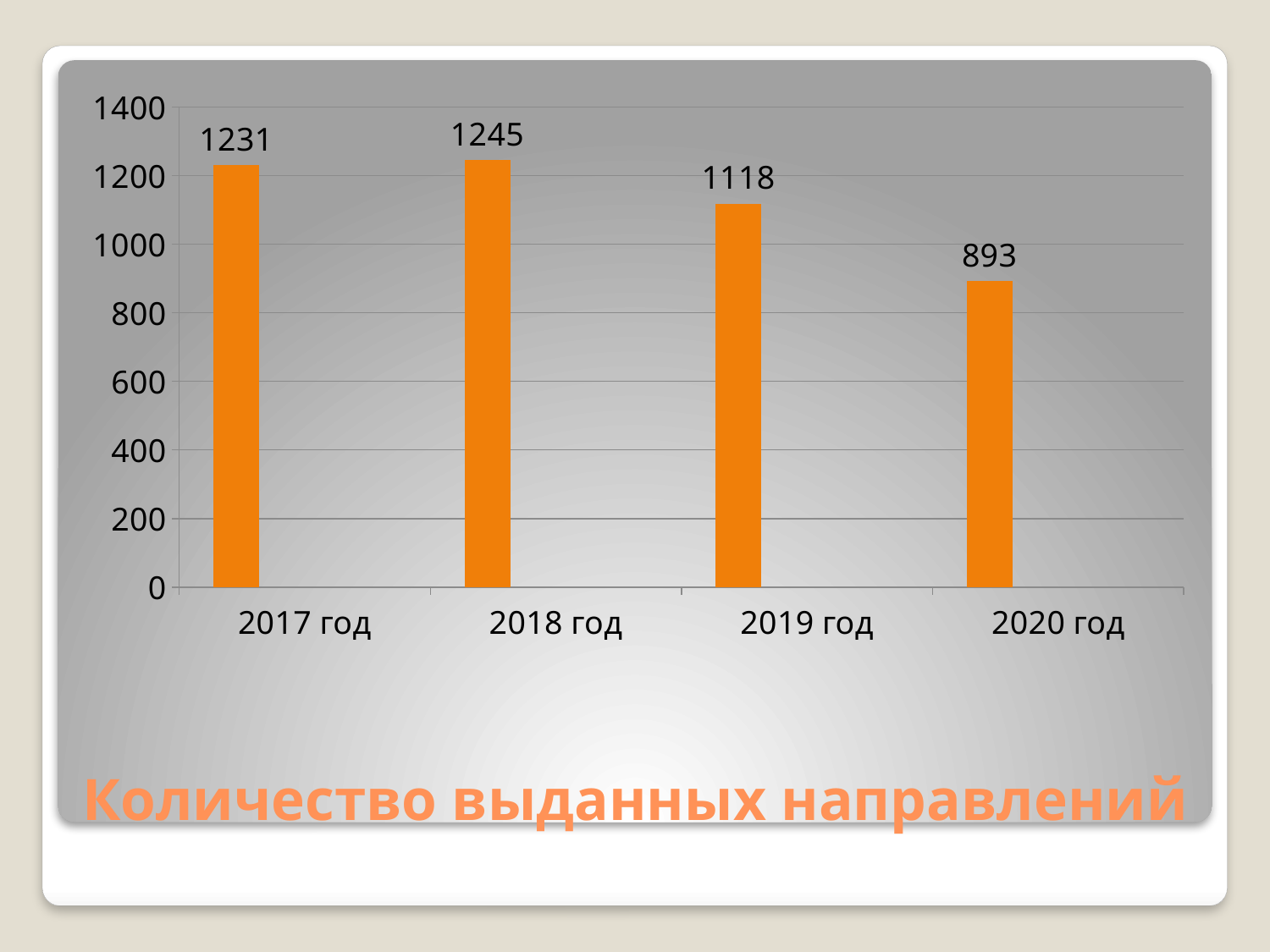
How many years are shown on the chart? 4 What is the value for 2020 год? 893 Which is larger, the value for 2017 год or the value for 2019 год? 2017 год What is the title of the chart? Количество выданных направлений What is the value for 2019 год? 1118 What is the value for 2017 год? 1231 What is the difference between the values for 2018 год and 2017 год? 14 Which year has the lowest value? 2020 год Which year has the highest value? 2018 год What is the value for 2018 год? 1245 What is the difference between the values for 2019 год and 2020 год? 225 What kind of chart is shown on the slide? Bar chart